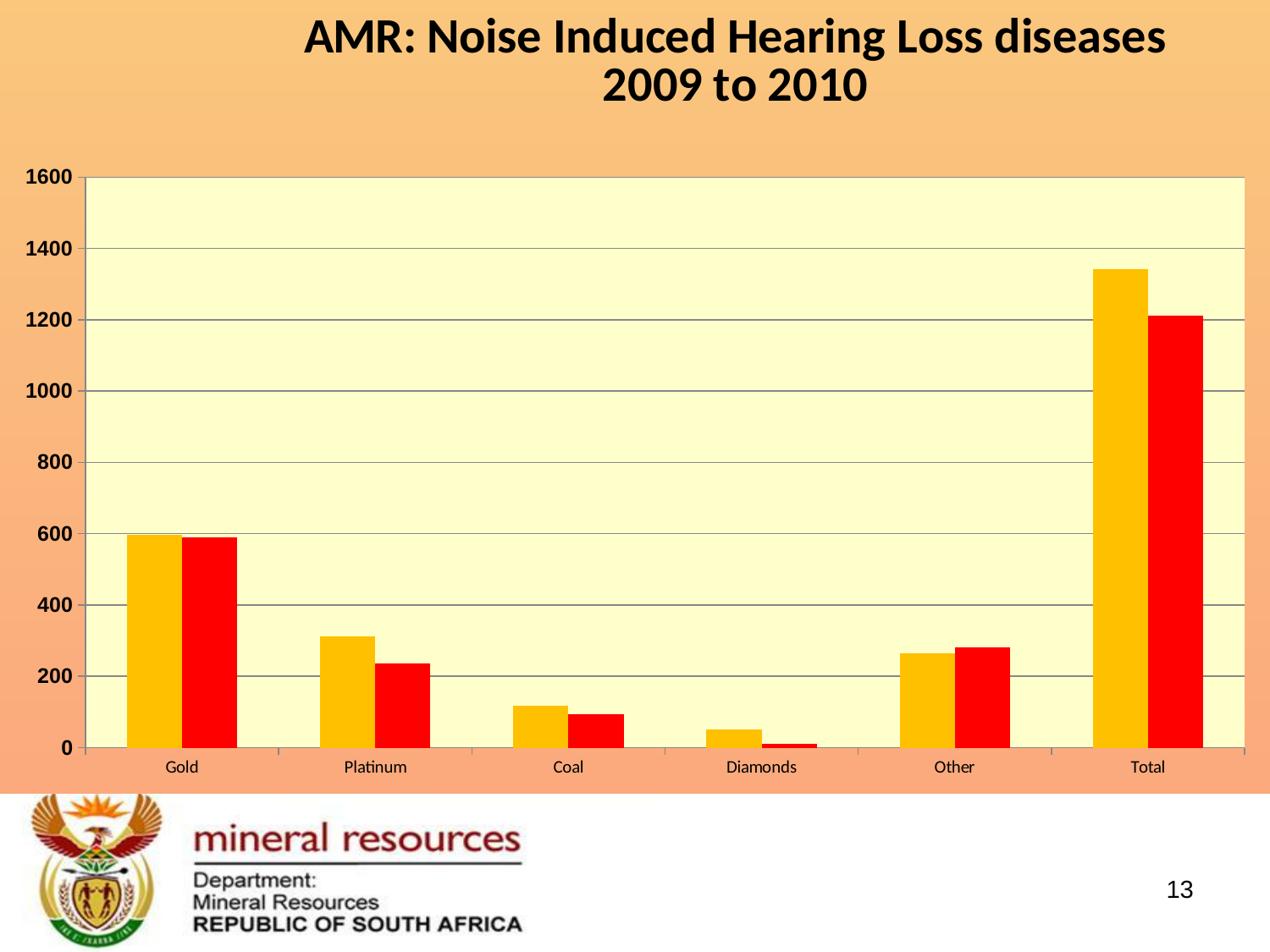
Which category has the lowest bars in the chart? Diamonds What kind of chart is shown on the slide? bar chart Is the yellow bar for Total greater or less than 1200? greater Is the yellow bar for Platinum greater or less than 200? greater For Platinum, which bar is taller, the yellow bar or the red bar? the yellow bar Is the yellow bar for Coal greater or less than 200? less Which category has the highest bars in the chart? Total How many categories are shown on the x axis of the chart? 6 What is the title of the chart on the slide? AMR: Noise Induced Hearing Loss diseases 2009 to 2010 Excluding Total, which category has the highest bars? Gold